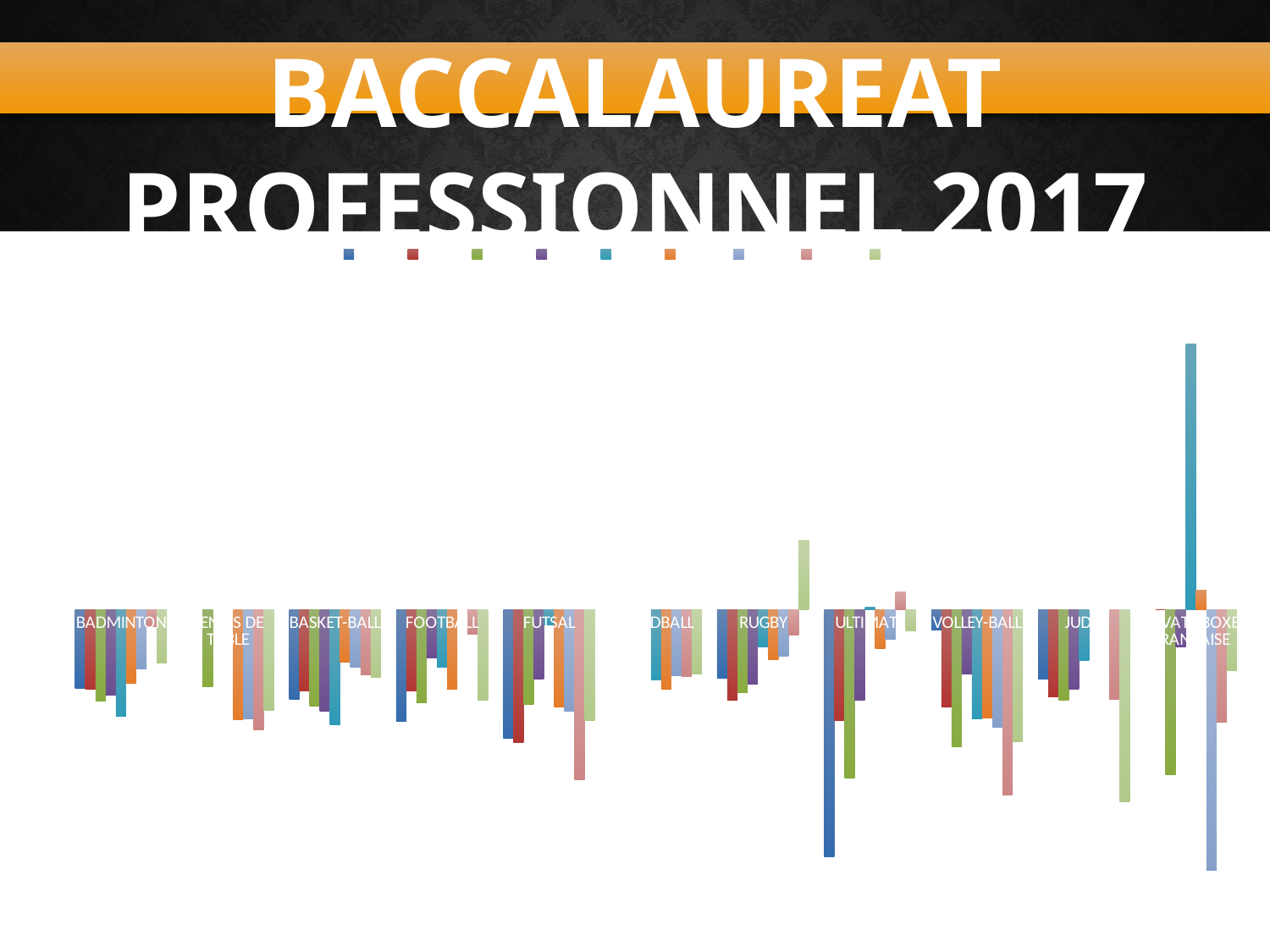
Which category contains the tallest bar above the baseline? SAVATE BOXE FRANCAISE (rightmost category) Which category is plotted first on the left of the x axis? BADMINTON How many categories are plotted along the x axis? 11 Which category has a bar extending above the baseline: BADMINTON or RUGBY? RUGBY Do most of the bars in the chart extend above or below the baseline? below How many series does the legend list? 9 What is the title shown above the chart? BACCALAUREAT PROFESSIONNEL 2017 What kind of chart is shown on the slide? bar chart